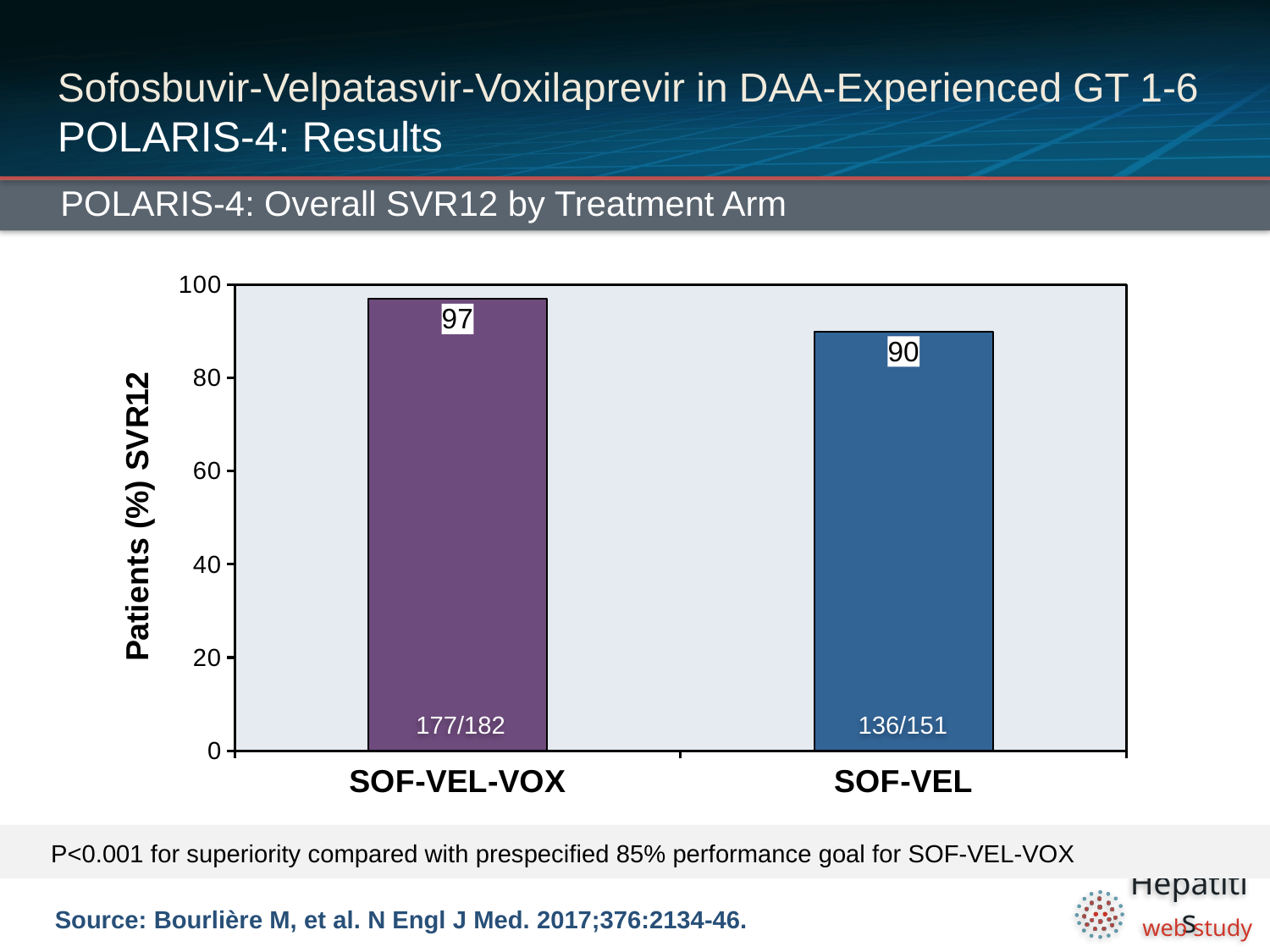
What is the SVR12 value for SOF-VEL-VOX? 97 What is the SVR12 value for SOF-VEL? 90 Which treatment arm has the lowest SVR12? SOF-VEL Is the value for SOF-VEL greater or less than 80? greater What is the label of the y axis? Patients (%) SVR12 What is the difference in SVR12 between SOF-VEL-VOX and SOF-VEL? 7 Which treatment arm has the highest SVR12? SOF-VEL-VOX How many treatment arms are shown in the chart? 2 What kind of chart is shown on the slide? bar chart Which is larger, the SVR12 for SOF-VEL-VOX or for SOF-VEL? SOF-VEL-VOX What fraction of patients is shown inside the SOF-VEL bar? 136/151 What fraction of patients is shown inside the SOF-VEL-VOX bar? 177/182